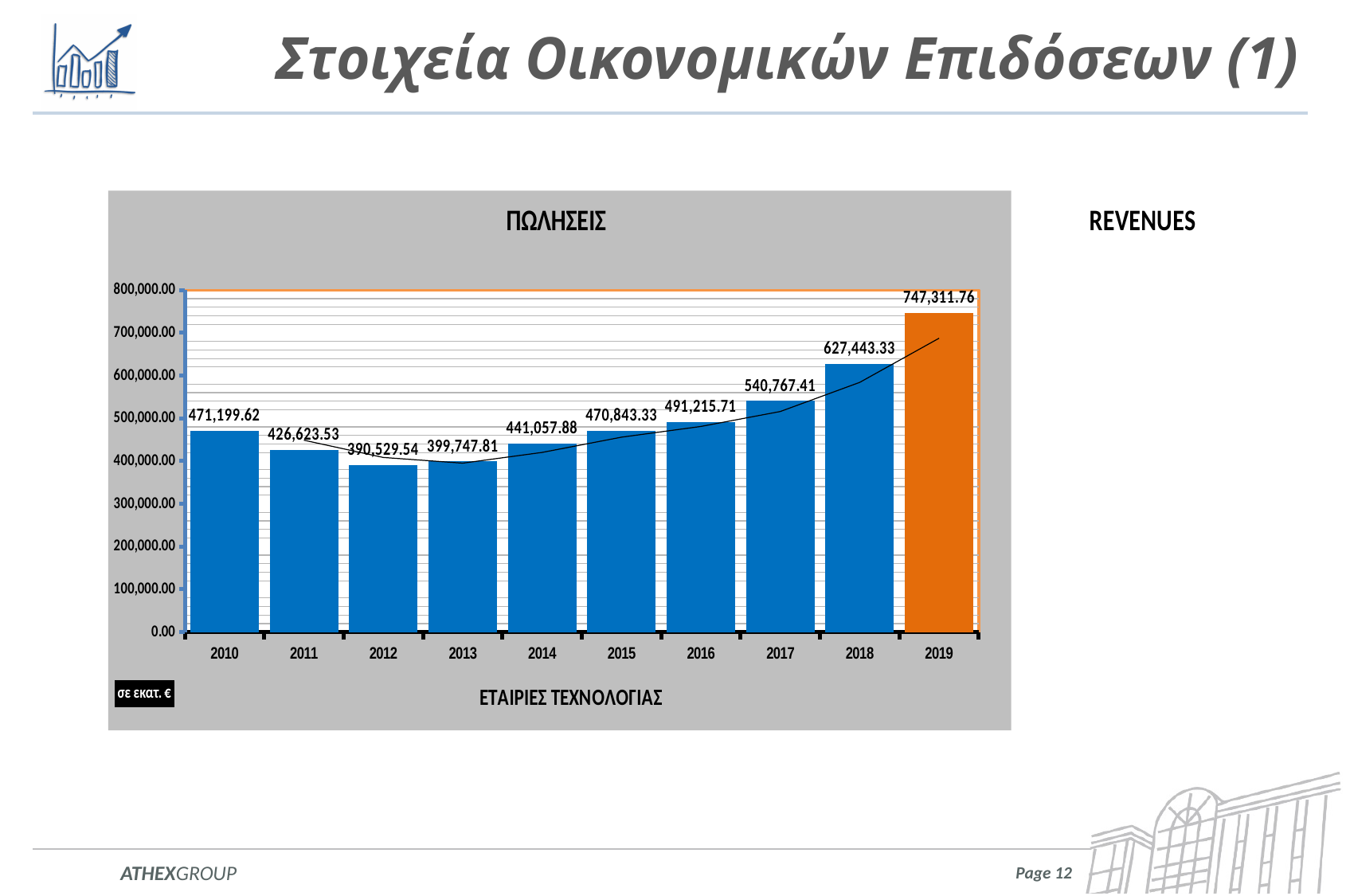
What is the value for 2012 in the ΠΩΛΗΣΕΙΣ chart? 390,529.54 What is the difference between the 2010 and 2011 values in the ΠΩΛΗΣΕΙΣ chart? 44,576.09 Which year has the lowest value in the ΠΩΛΗΣΕΙΣ chart? 2012 Which year has the larger value in the ΠΩΛΗΣΕΙΣ chart, 2014 or 2015? 2015 Which year has the highest value in the ΠΩΛΗΣΕΙΣ chart? 2019 Is the value for 2017 in the ΠΩΛΗΣΕΙΣ chart greater or less than 500,000.00? greater What kind of chart is the ΠΩΛΗΣΕΙΣ chart? bar chart What is the value for 2016 in the ΠΩΛΗΣΕΙΣ chart? 491,215.71 What is the x-axis label of the ΠΩΛΗΣΕΙΣ chart? ΕΤΑΙΡΙΕΣ ΤΕΧΝΟΛΟΓΙΑΣ What is the difference between the 2019 and 2018 values in the ΠΩΛΗΣΕΙΣ chart? 119,868.43 How many years are shown on the x axis of the ΠΩΛΗΣΕΙΣ chart? 10 What is the value for 2019 in the ΠΩΛΗΣΕΙΣ chart? 747,311.76